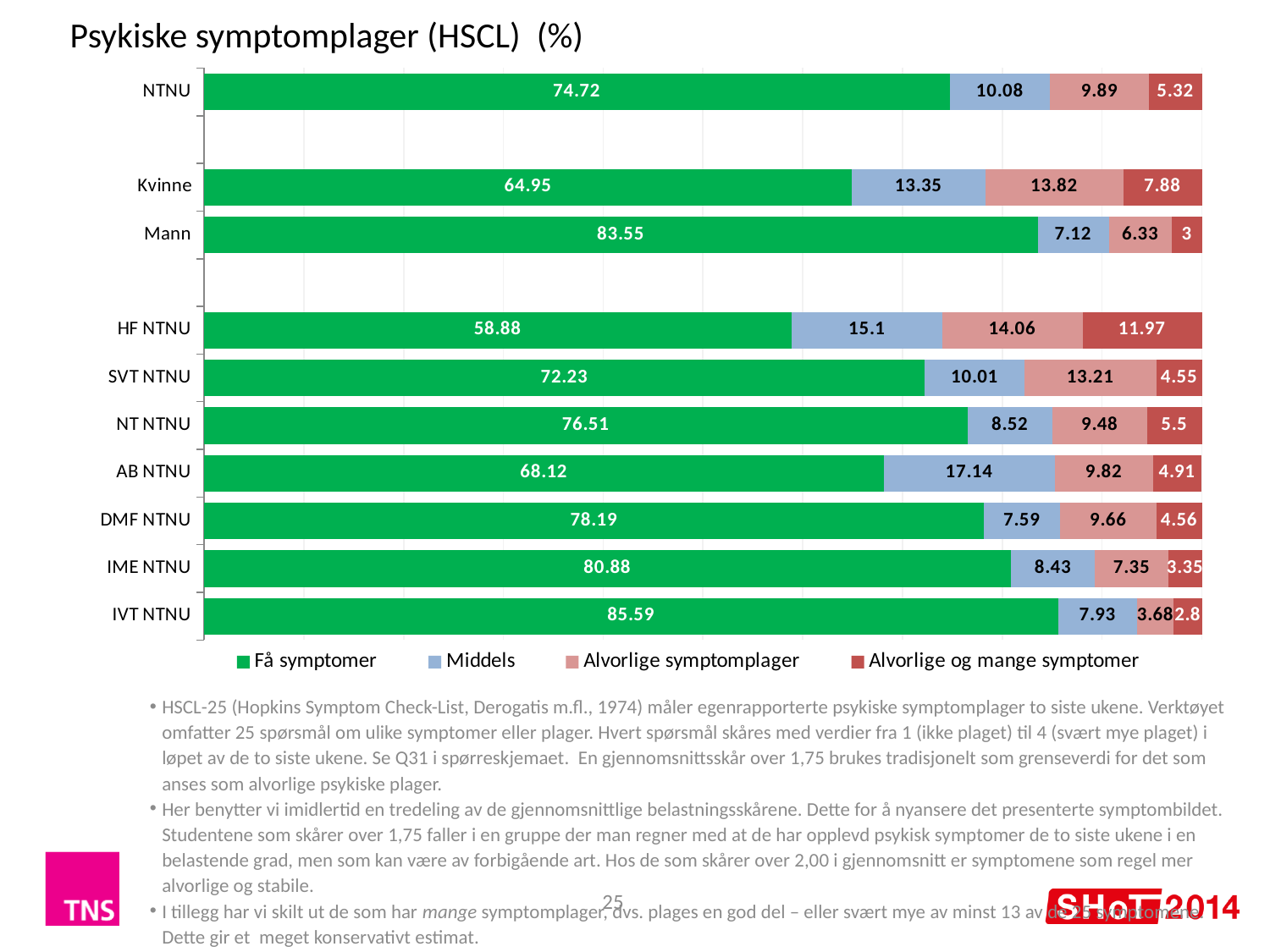
What kind of chart is shown on the slide? Stacked bar chart What is the title of the chart? Psykiske symptomplager (HSCL) (%) What is the difference between the Få symptomer values for Mann and Kvinne? 18.6 What is the value of Alvorlige symptomplager for Kvinne? 13.82 How many series does the legend list? 4 What is the value of Få symptomer for NTNU? 74.72 Which category has the lowest value for Få symptomer? HF NTNU Which category has the highest value for Få symptomer? IVT NTNU What is the value of Alvorlige og mange symptomer for HF NTNU? 11.97 What is the value of Middels for AB NTNU? 17.14 Which has a larger Middels value, Kvinne or Mann? Kvinne How many categories are shown on the chart? 10